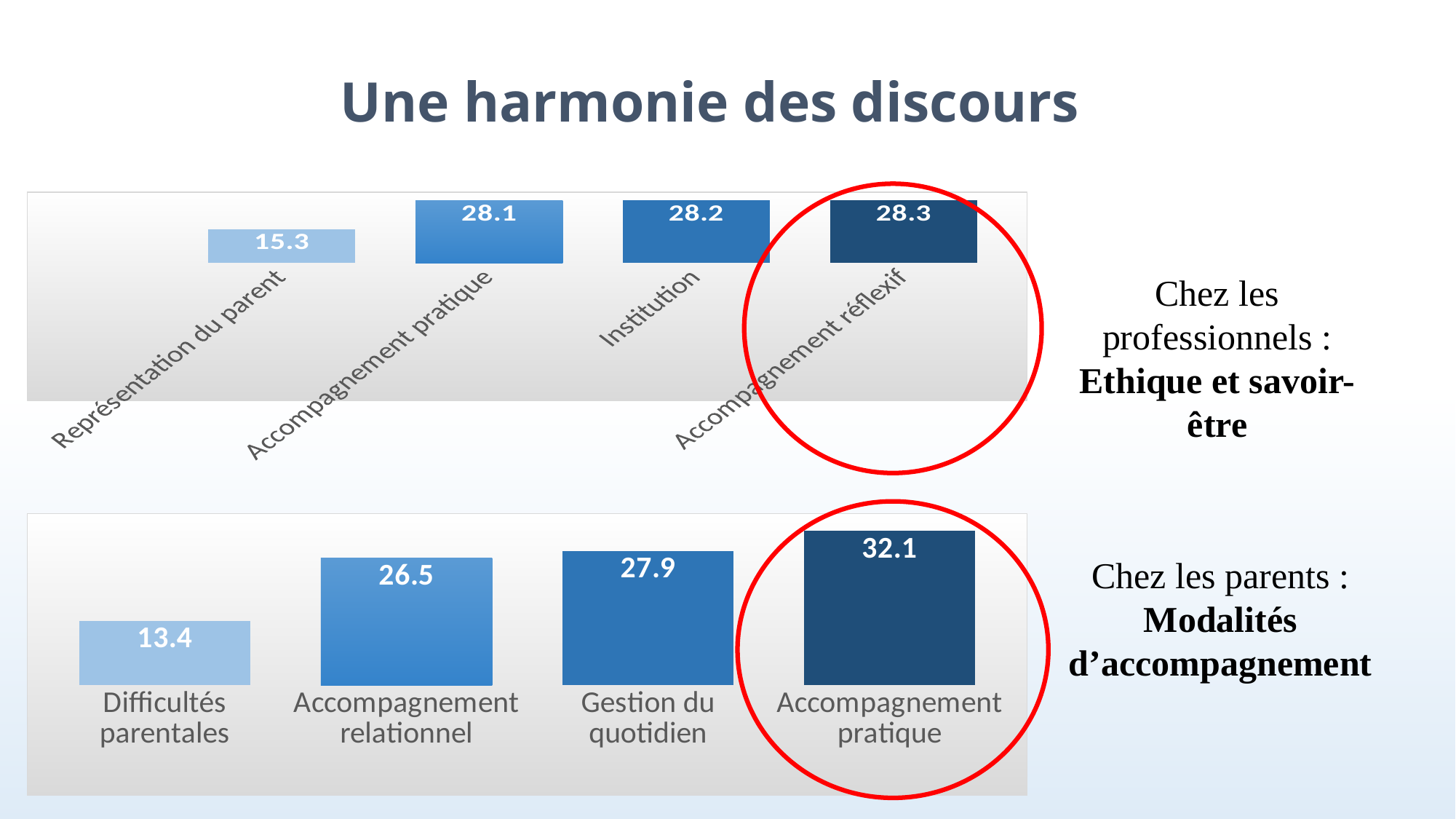
In the top chart, which category has the lowest value? Représentation du parent In the bottom chart, what is the value for Difficultés parentales? 13.4 In the bottom chart, what is the difference between Accompagnement pratique and Accompagnement relationnel? 5.6 In the bottom chart, which category has the highest value? Accompagnement pratique In the top chart, what is the value for Institution? 28.2 How many categories does the bottom chart show? 4 What type of chart is the top chart? Bar chart In the top chart, what is the value for Représentation du parent? 15.3 In the bottom chart, what is the value for Gestion du quotidien? 27.9 In the top chart, which category has the highest value? Accompagnement réflexif In the bottom chart, which is larger: Gestion du quotidien or Difficultés parentales? Gestion du quotidien In the top chart, what is the difference between Accompagnement réflexif and Représentation du parent? 13.0